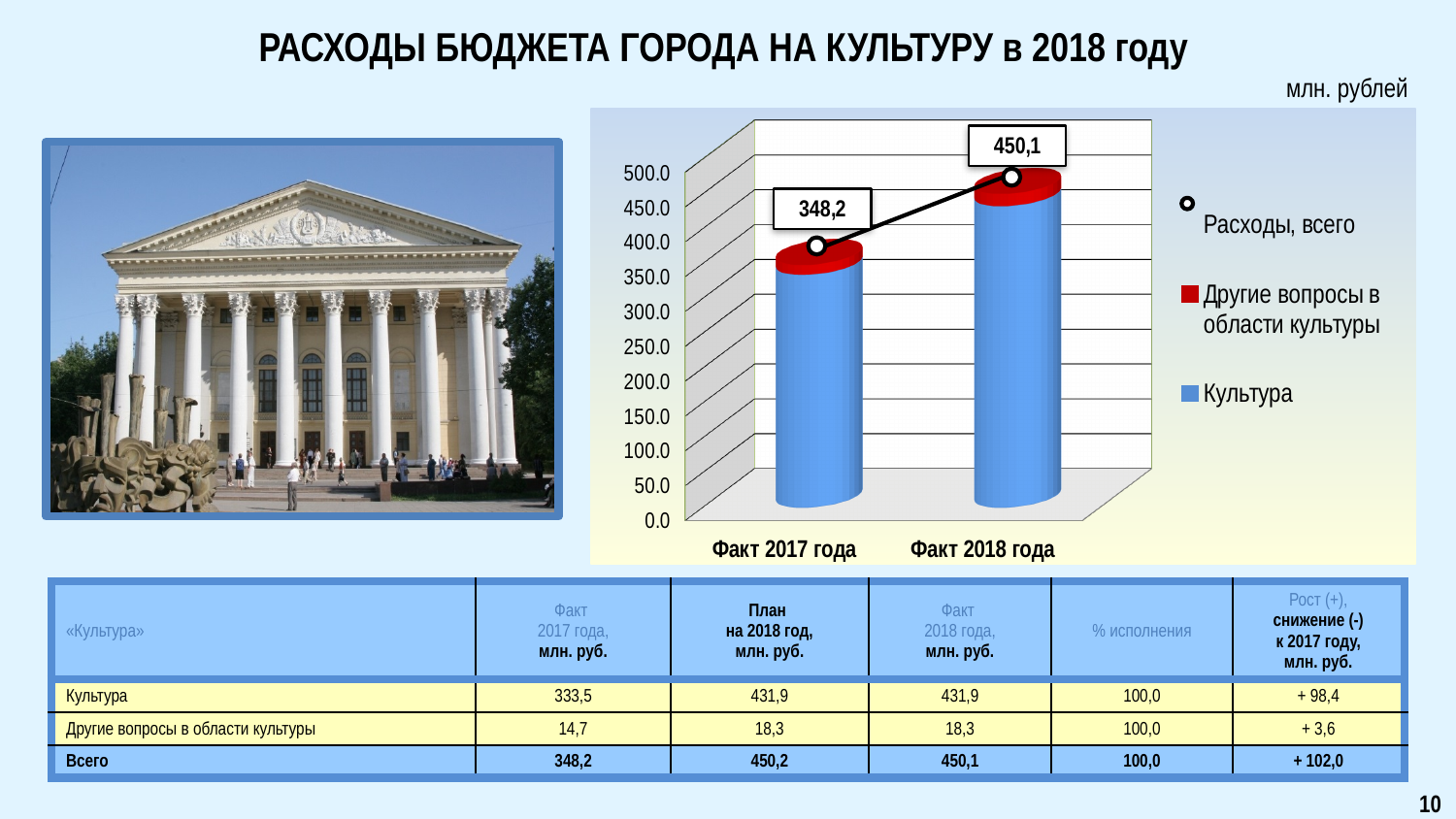
What is the value of Расходы, всего for Факт 2017 года? 348,2 Is the Культура segment for Факт 2018 года greater or less than 400.0? greater Is the Культура segment for Факт 2017 года greater or less than 300.0? greater Do total expenditures rise or fall from Факт 2017 года to Факт 2018 года? Rise Which is larger, Расходы, всего for Факт 2017 года or for Факт 2018 года? Факт 2018 года Which category has the lowest total expenditure? Факт 2017 года What kind of chart is shown on the slide? Stacked bar chart By how much does Расходы, всего for Факт 2018 года exceed Факт 2017 года? 101,9 What is the value of Расходы, всего for Факт 2018 года? 450,1 How many categories are shown on the x axis of the chart? 2 How many series does the chart legend list? 3 Which category has the highest total expenditure? Факт 2018 года